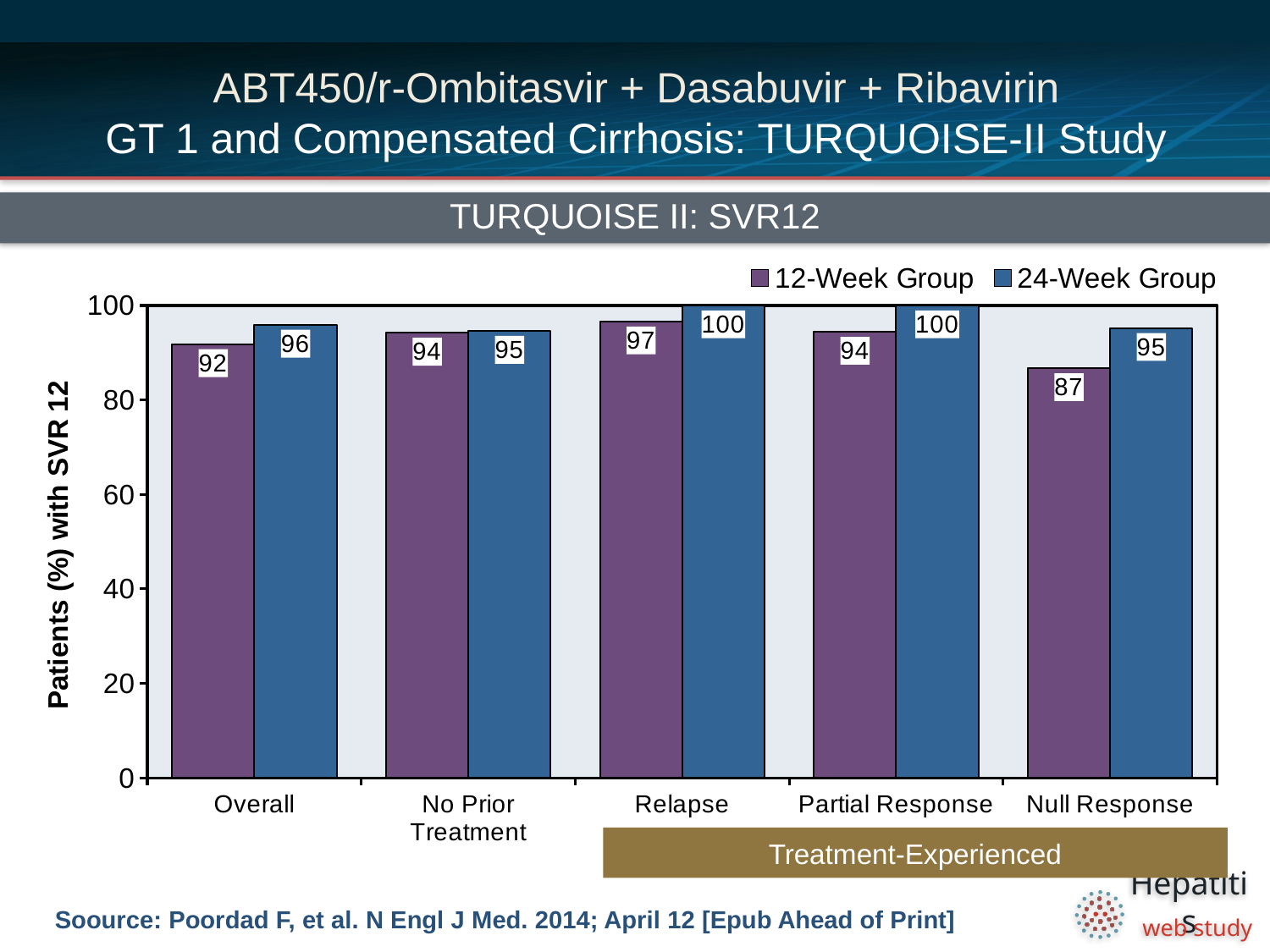
What is the difference between the 24-Week Group and 12-Week Group values in the Null Response category? 8 What is the SVR12 rate for the 24-Week Group in the Null Response category? 95 What is the value for the 24-Week Group in the Relapse category? 100 What kind of chart is shown on the slide? Bar chart Which category has the highest value for the 12-Week Group? Relapse What is the SVR12 rate for the 12-Week Group in the Overall category? 92 How many series does the legend list? 2 Which category has the lowest value for the 12-Week Group? Null Response What is the label of the y axis? Patients (%) with SVR 12 In the Partial Response category, which group has the larger value, the 12-Week Group or the 24-Week Group? 24-Week Group How many categories are shown on the x axis? 5 Is the value for the 12-Week Group in the Null Response category greater or less than 80? greater